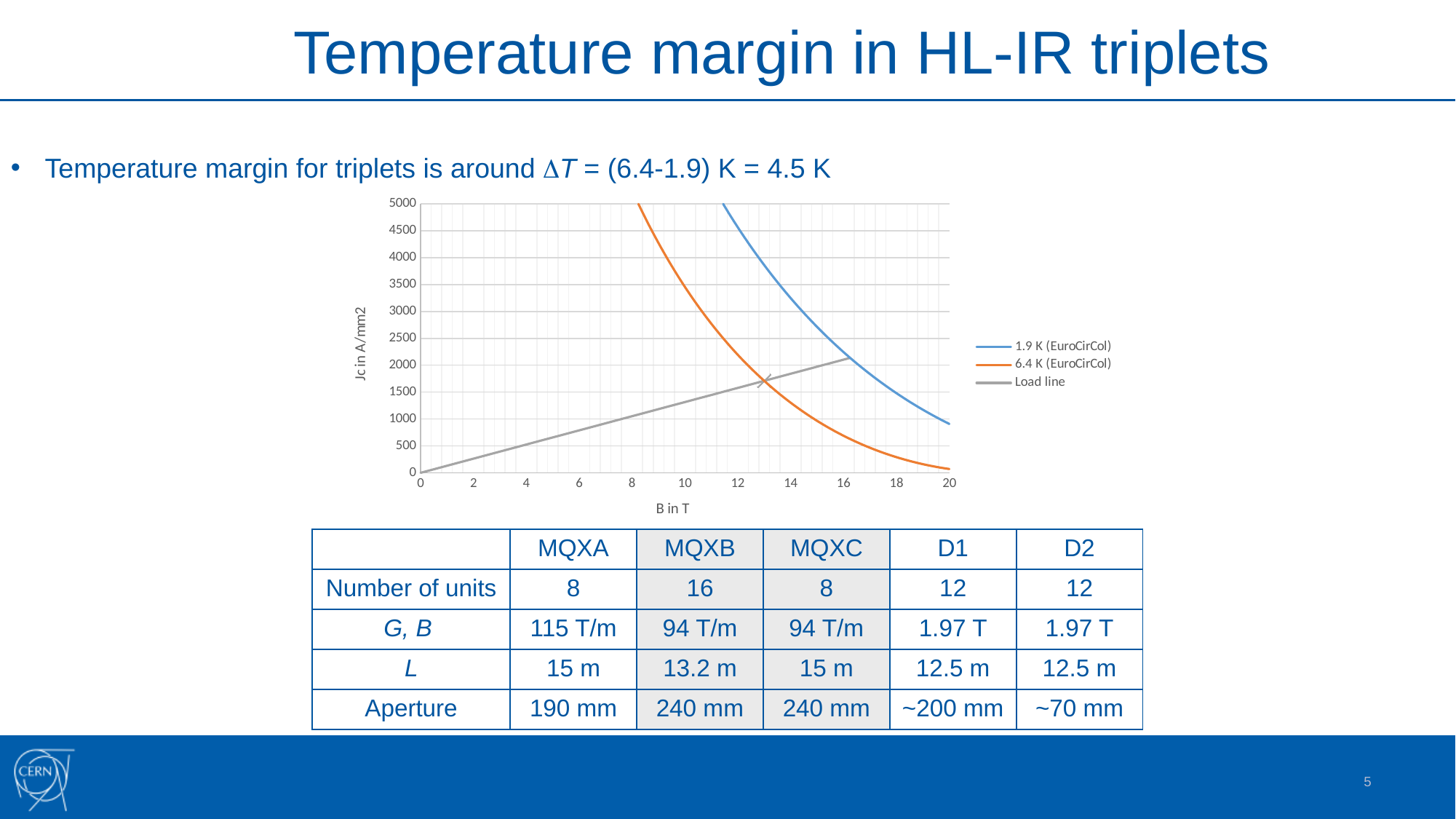
Is the value of the 6.4 K (EuroCirCol) curve at B = 12 T greater or less than 2000? greater Is the value of the 1.9 K (EuroCirCol) curve at B = 18 T greater or less than 1000? greater At B = 14 T, which series has the higher Jc value: 1.9 K (EuroCirCol) or 6.4 K (EuroCirCol)? 1.9 K (EuroCirCol) Does the Load line rise or fall as B increases? rise Is the value of the Load line at B = 10 T greater or less than 1000? greater What kind of chart is shown on the slide? line chart What are the three series listed in the chart legend? 1.9 K (EuroCirCol), 6.4 K (EuroCirCol), Load line What is the label of the x axis of the chart? B in T Does the 6.4 K (EuroCirCol) curve rise or fall as B increases? fall How many series does the chart legend list? 3